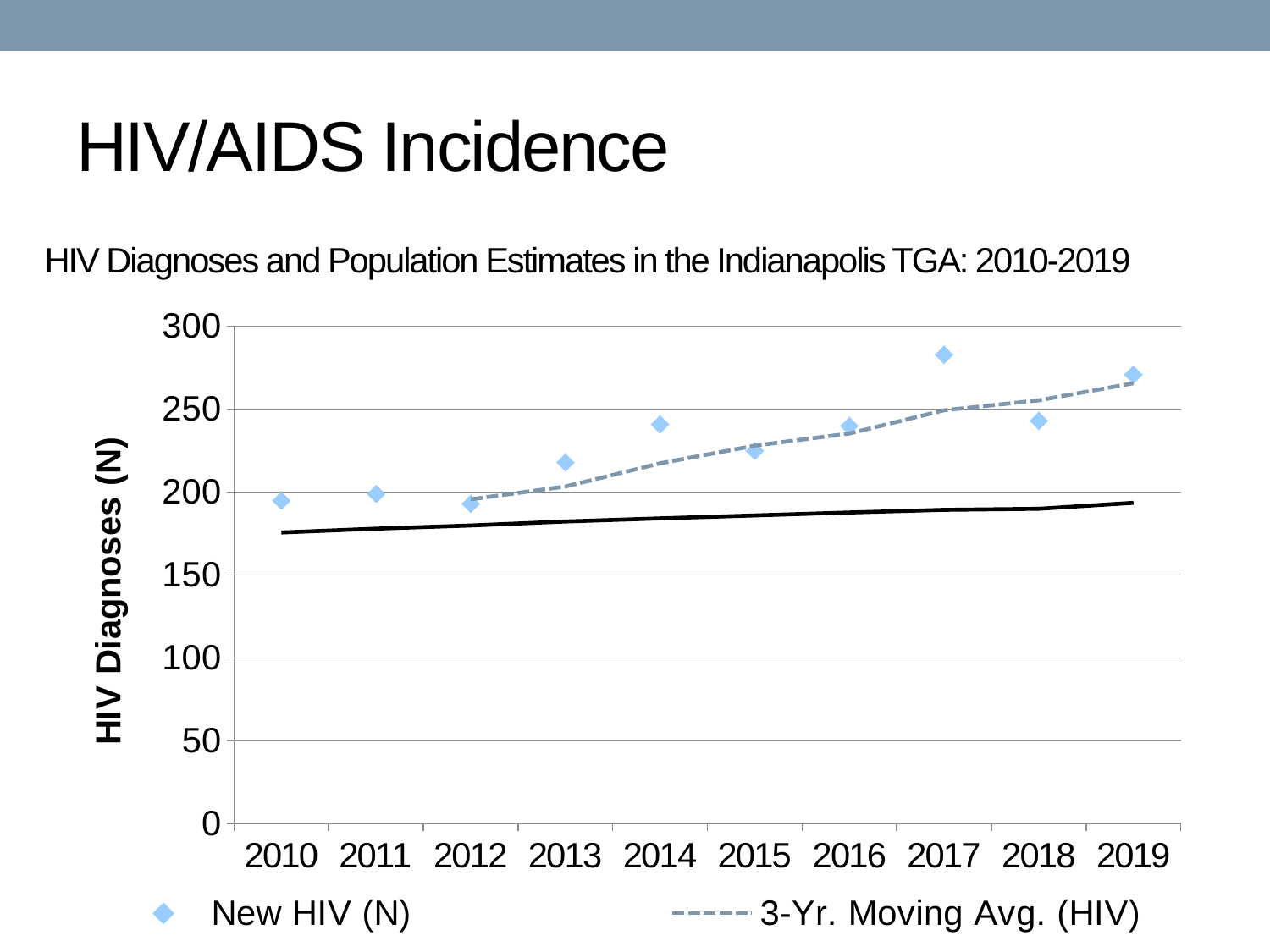
How many years are shown on the x axis of the chart? 10 How many series does the chart legend list? 2 Is the New HIV (N) value for 2019 greater or less than 250? greater Which year has the larger New HIV (N) value, 2017 or 2018? 2017 In which year is the New HIV (N) value highest? 2017 What is the title of the chart? HIV Diagnoses and Population Estimates in the Indianapolis TGA: 2010-2019 What is the title of the y axis? HIV Diagnoses (N) Is the New HIV (N) value for 2013 greater or less than 200? greater Is the New HIV (N) value for 2017 greater or less than 250? greater Which year has the larger New HIV (N) value, 2011 or 2014? 2014 Does the 3-Yr. Moving Avg. (HIV) line rise or fall from 2012 to 2019? rise